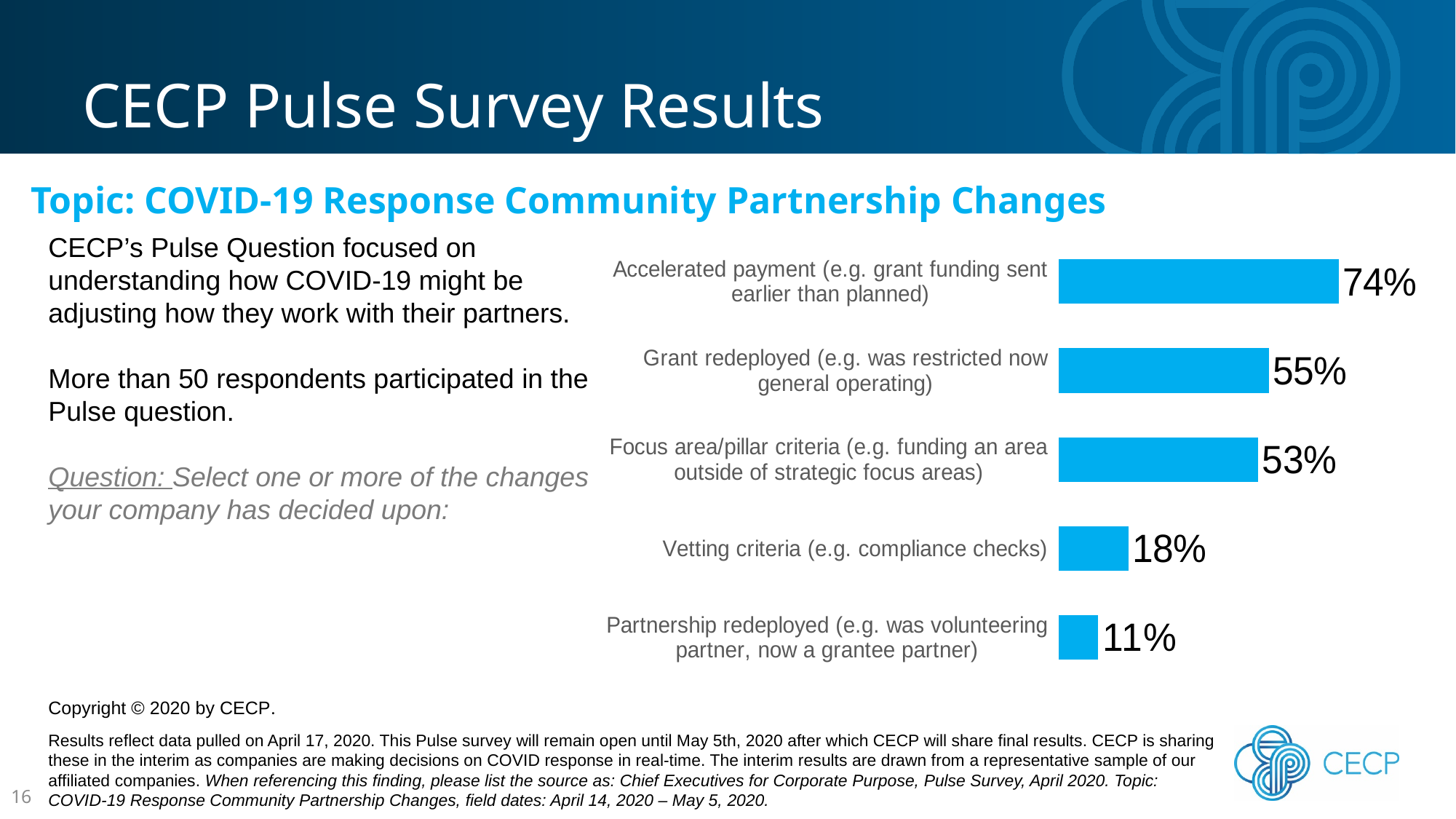
What is the difference in percentage points between "Vetting criteria" and "Partnership redeployed"? 7 What is the value shown for "Vetting criteria (e.g. compliance checks)"? 18% Which has a larger value: "Focus area/pillar criteria" or "Vetting criteria"? Focus area/pillar criteria Which change was selected by the lowest percentage of respondents? Partnership redeployed (e.g. was volunteering partner, now a grantee partner) What percentage of respondents selected "Accelerated payment (e.g. grant funding sent earlier than planned)"? 74% What is the value shown for "Grant redeployed (e.g. was restricted now general operating)"? 55% Which change was selected by the highest percentage of respondents? Accelerated payment (e.g. grant funding sent earlier than planned) What is the difference in percentage points between "Accelerated payment" and "Grant redeployed"? 19 What colour are the bars in the chart? Blue What type of chart is shown on the slide? Bar chart How many categories are shown in the bar chart? 5 What is the value shown for "Partnership redeployed (e.g. was volunteering partner, now a grantee partner)"? 11%